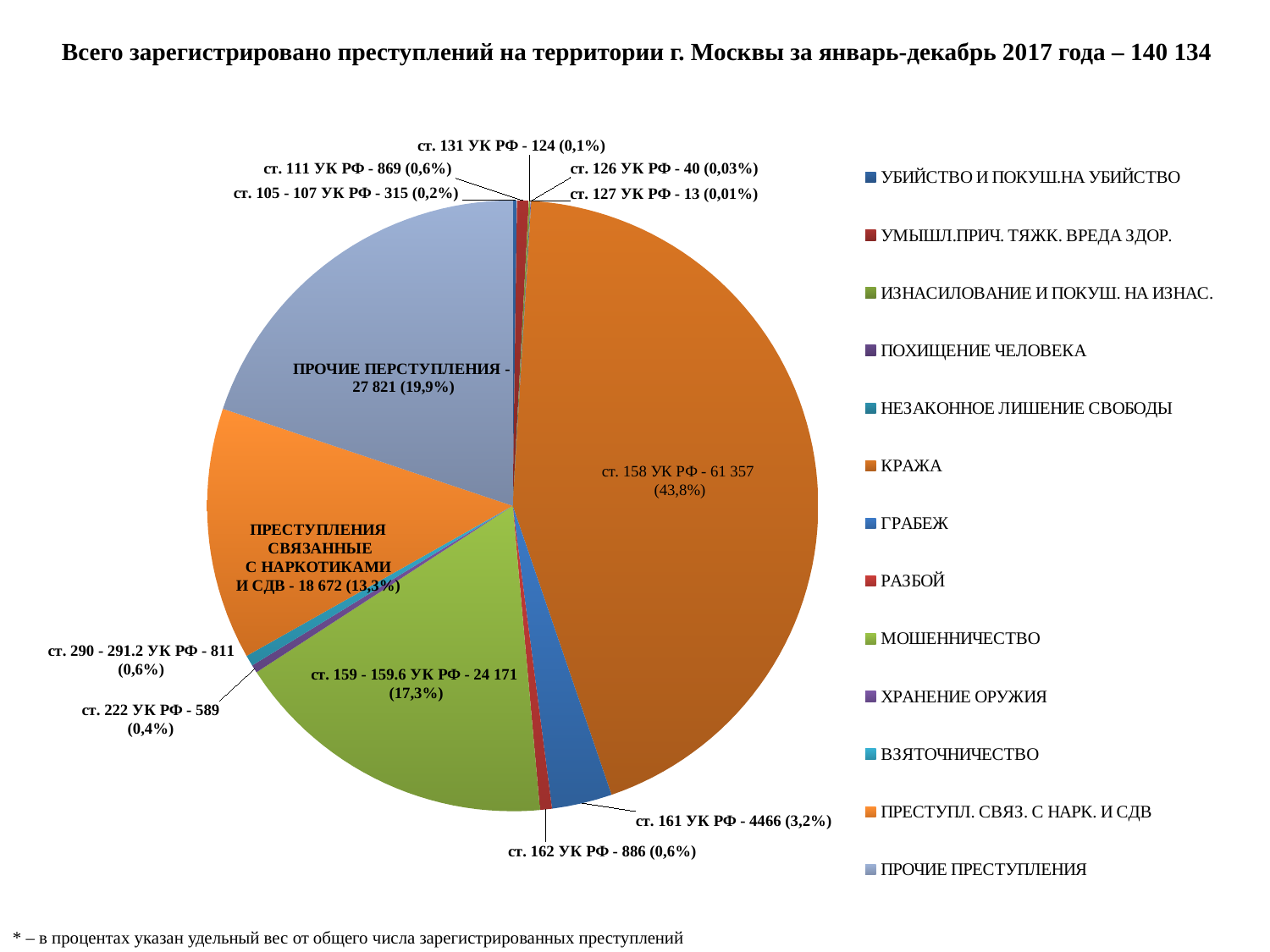
What share of the pie does ПРЕСТУПЛЕНИЯ СВЯЗАННЫЕ С НАРКОТИКАМИ И СДВ represent? 13,3% What is the value shown for ст. 126 УК РФ? 40 (0,03%) What type of chart is shown on the slide? pie chart Which is larger, the value for ст. 111 УК РФ or the value for ст. 222 УК РФ? ст. 111 УК РФ Which slice is the smallest? ст. 127 УК РФ - 13 (0,01%) What total number of registered crimes is stated in the slide title? 140 134 What is the value shown for ст. 158 УК РФ? 61 357 (43,8%) What is the difference between the values for ст. 161 УК РФ and ст. 162 УК РФ? 3580 Which slice is the largest? ст. 158 УК РФ - 61 357 (43,8%) What is the value shown for ПРОЧИЕ ПЕРСТУПЛЕНИЯ? 27 821 (19,9%) How many entries does the legend list? 13 What is the value shown for ст. 159 - 159.6 УК РФ? 24 171 (17,3%)